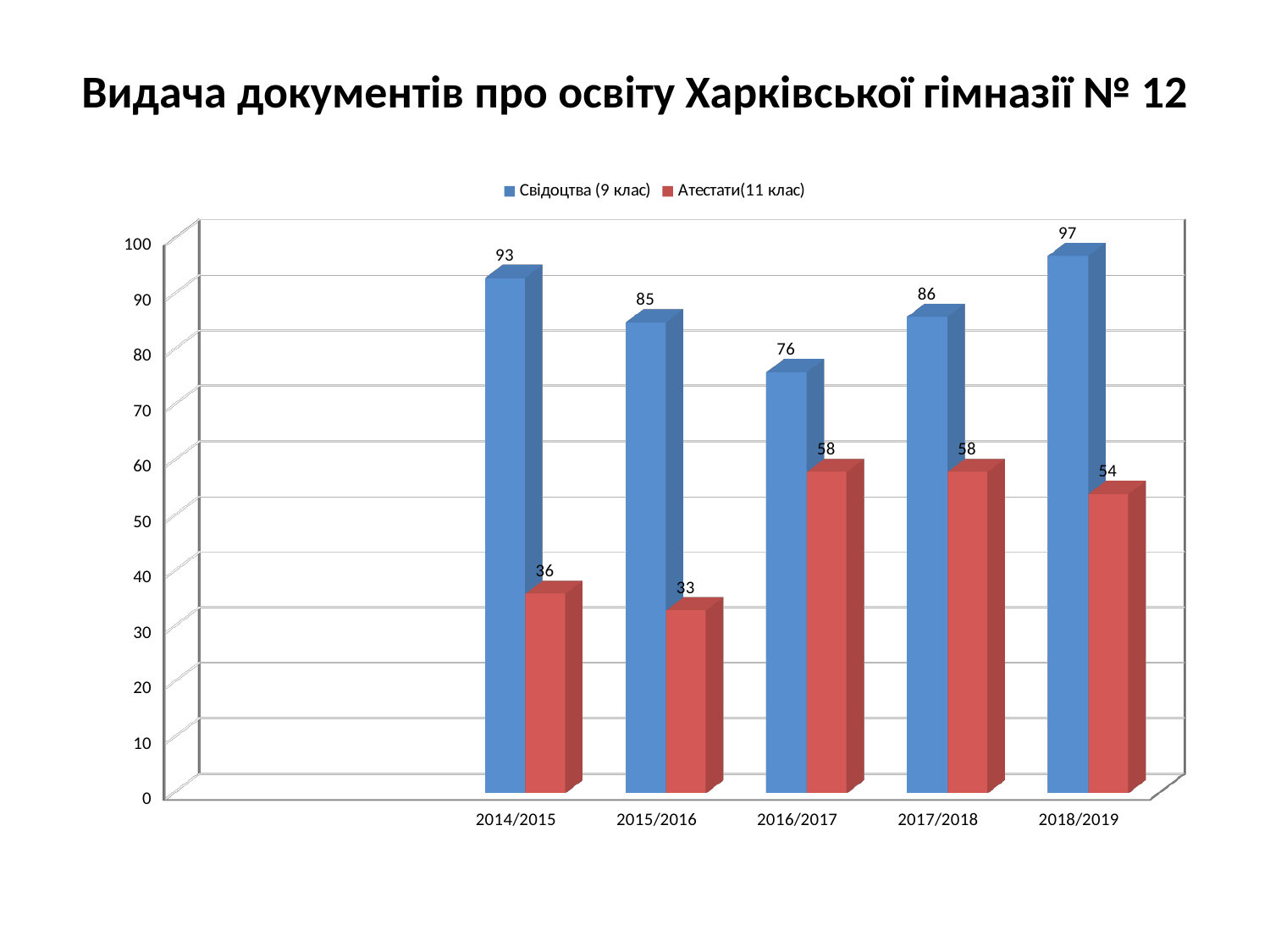
How many years are shown on the x axis? 5 What kind of chart is shown on the slide? Bar chart What is the value for Свідоцтва (9 клас) in 2014/2015? 93 How many series does the legend list? 2 What is the value for Атестати(11 клас) in 2015/2016? 33 Which is larger: Свідоцтва (9 клас) in 2015/2016 or Свідоцтва (9 клас) in 2017/2018? 2017/2018 Which year has the highest value for Свідоцтва (9 клас)? 2018/2019 What is the value for Атестати(11 клас) in 2018/2019? 54 Which year has the lowest value for Атестати(11 клас)? 2015/2016 What colour are the bars for Атестати(11 клас)? Red What is the difference between Свідоцтва (9 клас) and Атестати(11 клас) in 2016/2017? 18 Does the value for Атестати(11 клас) rise or fall from 2015/2016 to 2016/2017? Rise